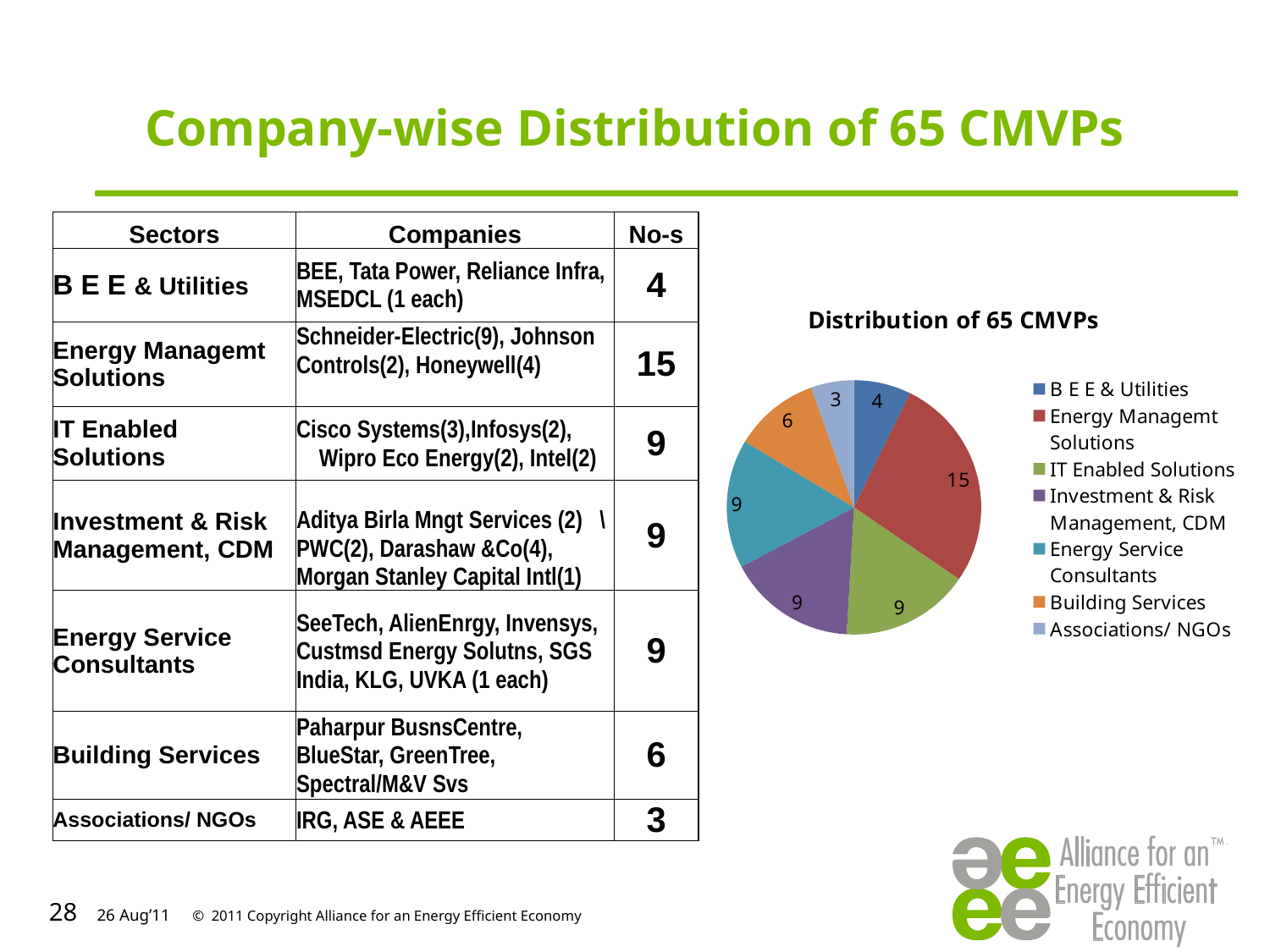
What is the difference between the values for Energy Managemt Solutions and Building Services? 9 What is the value for B E E & Utilities in the pie chart? 4 Which is larger in the pie chart, B E E & Utilities or Building Services? Building Services How many entries does the chart legend list? 7 How many slices does the pie chart have? 7 What is the value for Energy Managemt Solutions in the pie chart? 15 What is the value for Building Services in the pie chart? 6 Which category has the smallest slice in the pie chart? Associations/ NGOs What is the title of the chart? Distribution of 65 CMVPs Which category has the largest slice in the pie chart? Energy Managemt Solutions What is the value for Associations/ NGOs in the pie chart? 3 What kind of chart is shown on the slide? pie chart